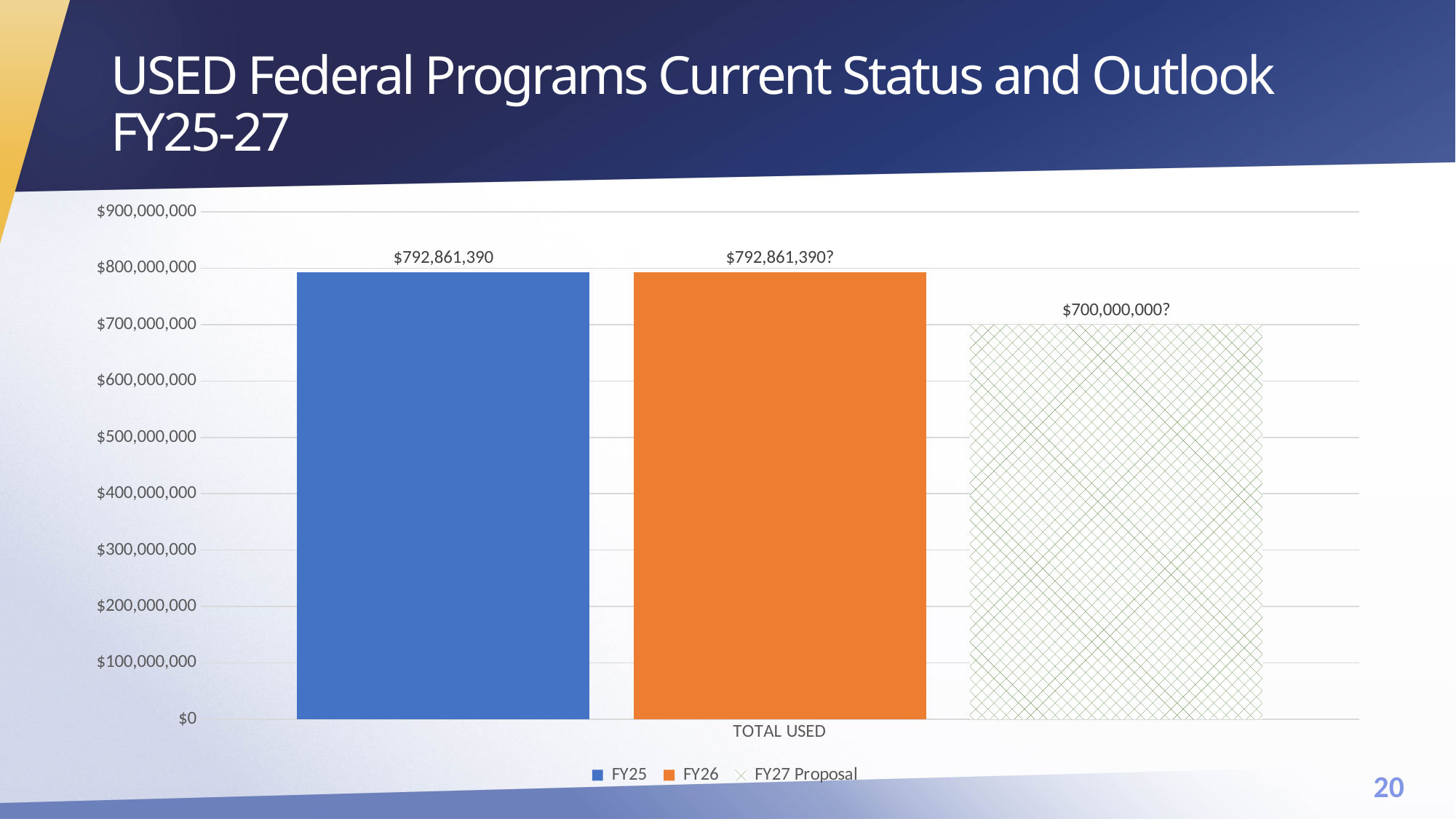
What is the difference between the FY25 value and the FY27 Proposal value? $92,861,390 What kind of chart is shown on the slide? bar chart What is the category label on the x axis? TOTAL USED Is the value for FY25 greater or less than $700,000,000? greater Is the value for FY27 Proposal greater or less than $800,000,000? less Which is larger, the FY25 bar or the FY27 Proposal bar? FY25 What is the data label on the FY26 bar? $792,861,390? What is the data label on the FY27 Proposal bar? $700,000,000? How many categories are shown on the x axis? 1 What is the data label on the FY25 bar? $792,861,390 Which series has the lowest bar? FY27 Proposal How many series does the legend list? 3